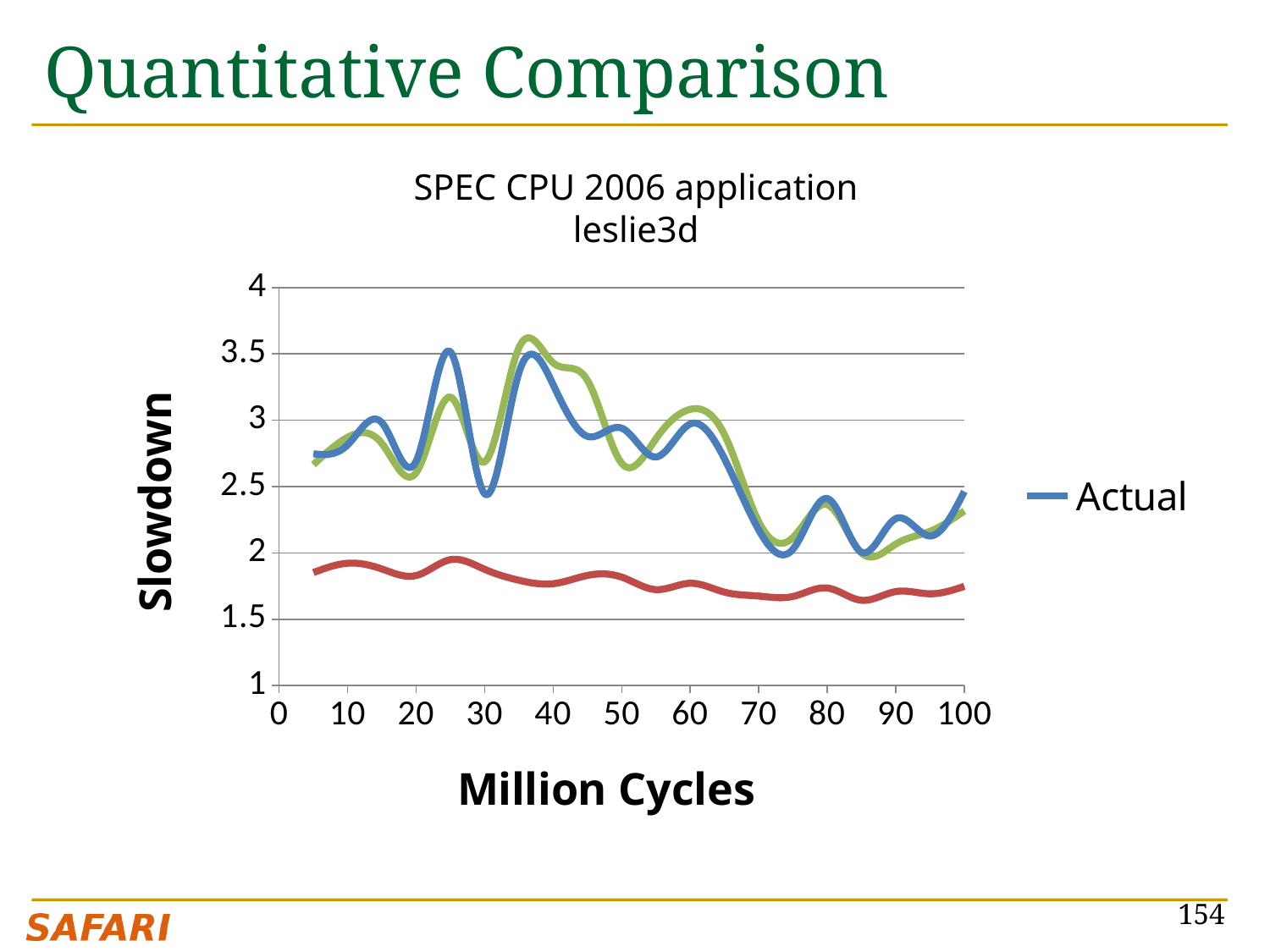
What kind of chart is shown on the slide? line chart Is the value of the Actual series at 75 million cycles greater or less than 2.5? less What is the title of the chart? SPEC CPU 2006 application leslie3d Is the value of the Actual series at 40 million cycles greater or less than 3? greater What is the name of the series listed in the legend? Actual Does the red line stay above or below 2 across the whole x axis? below Which plotted line has the lowest values across the whole x axis? the red line How many lines are plotted on the chart? 3 How many series does the chart legend list? 1 At 40 million cycles, which is higher: the Actual series or the red line? Actual